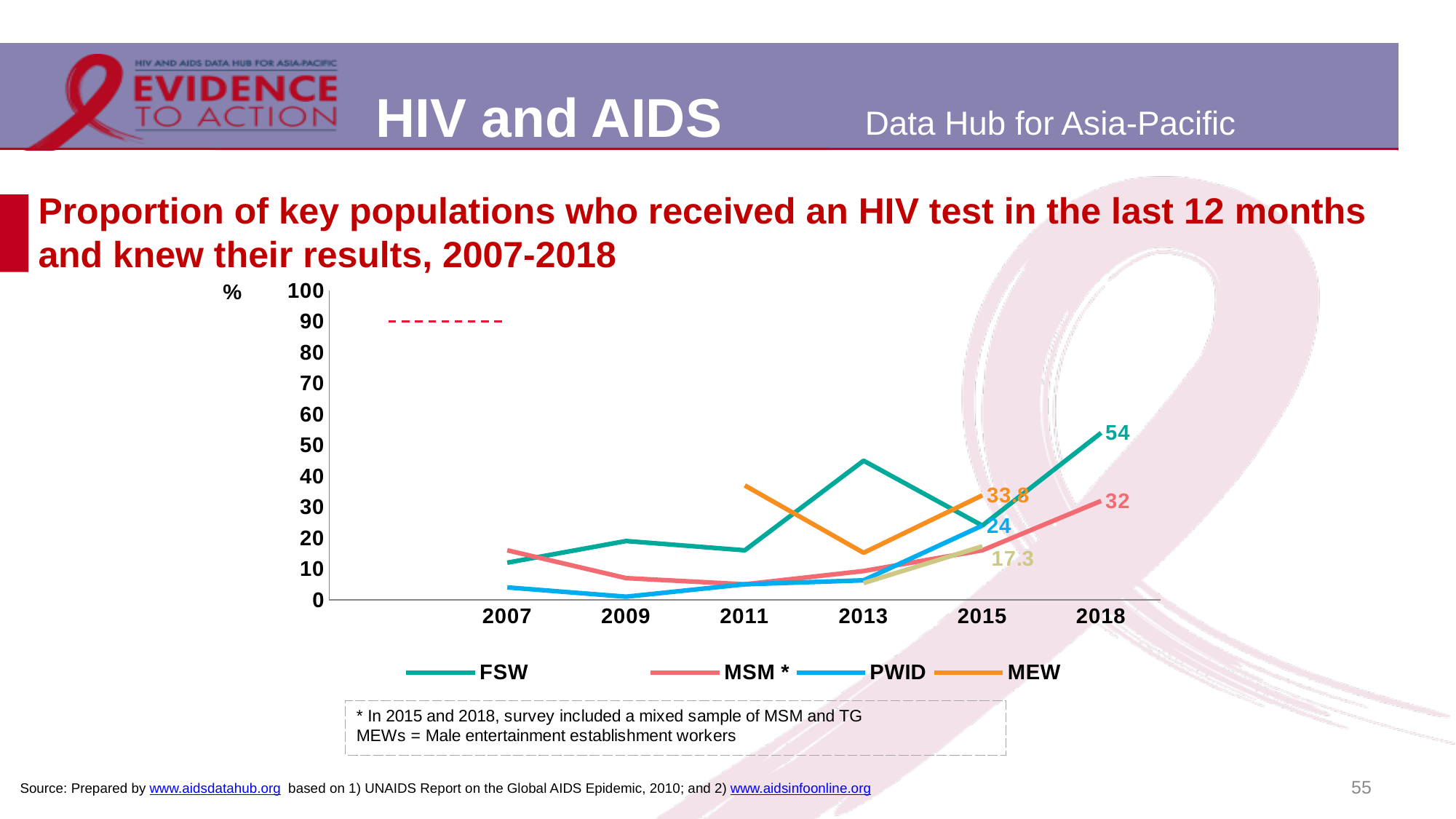
Is the value for FSW in 2013 greater or less than 40? greater How many years are shown on the x axis? 6 What is the value for MSM * in 2018? 32 What is the difference between the FSW and MSM * values in 2018? 22 Does the PWID line rise or fall from 2009 to 2015? rise Which series has the higher value in 2018, FSW or MSM *? FSW What kind of chart is shown on the slide? line chart What is the value for MEW in 2015? 33.8 Is the value for PWID in 2009 greater or less than 10? less What is the value for FSW in 2018? 54 How many series does the legend list? 4 What is the value for PWID in 2015? 24